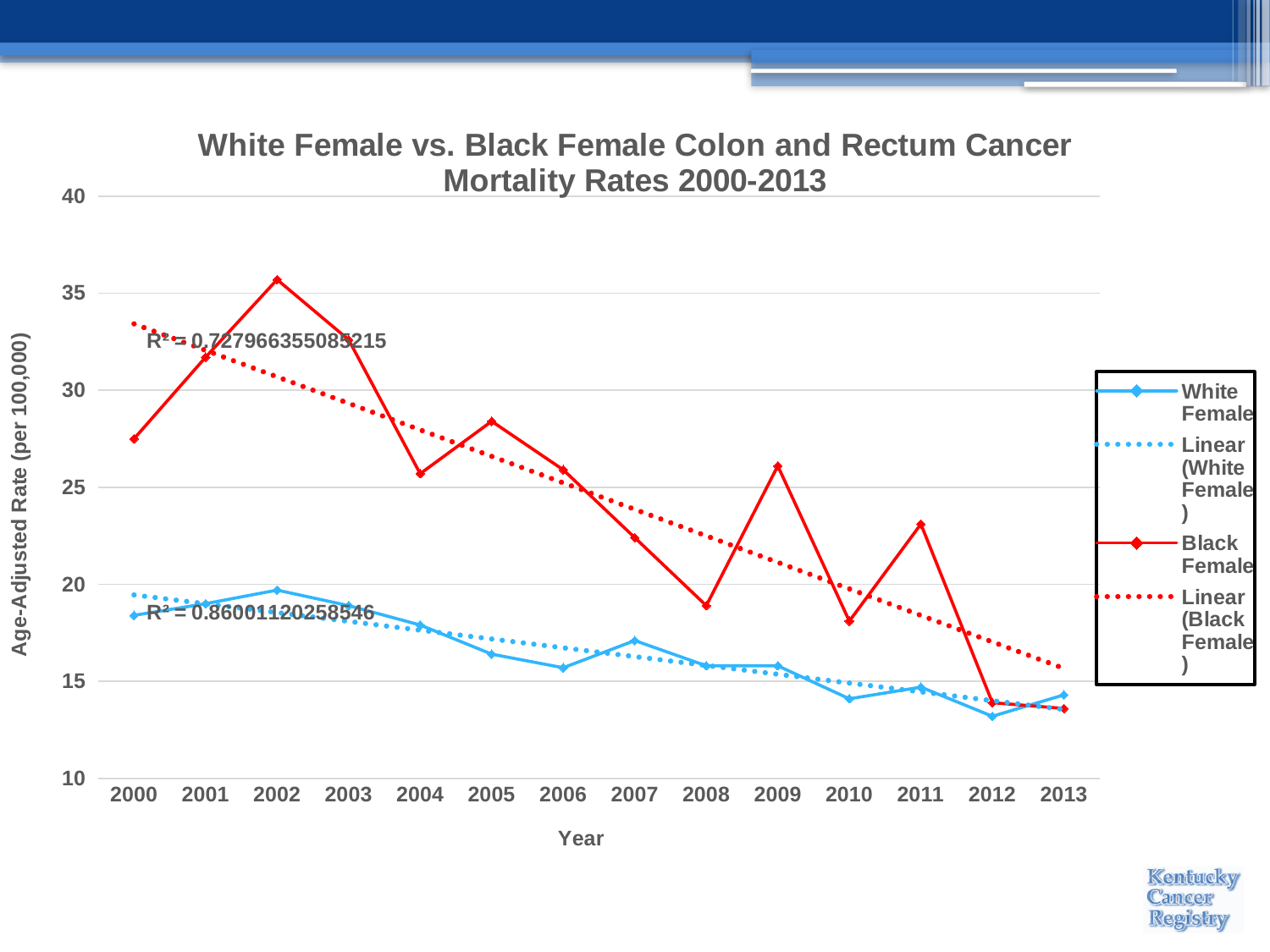
What is the label on the y axis? Age-Adjusted Rate (per 100,000) Is the Black Female value for 2009 greater or less than 25? greater How many entries does the legend list? 4 Which series has the larger value in 2005, White Female or Black Female? Black Female Is the Black Female value for 2000 greater or less than 25? greater What kind of chart is shown on the slide? Line chart What R² value is shown next to the White Female trend line? R² = 0.860011202585546 In which year does the Black Female mortality rate reach its highest value? 2002 How many years are plotted along the x axis? 14 Is the White Female value for 2010 greater or less than 15? less Does the White Female mortality rate generally rise or fall from 2000 to 2013? Fall